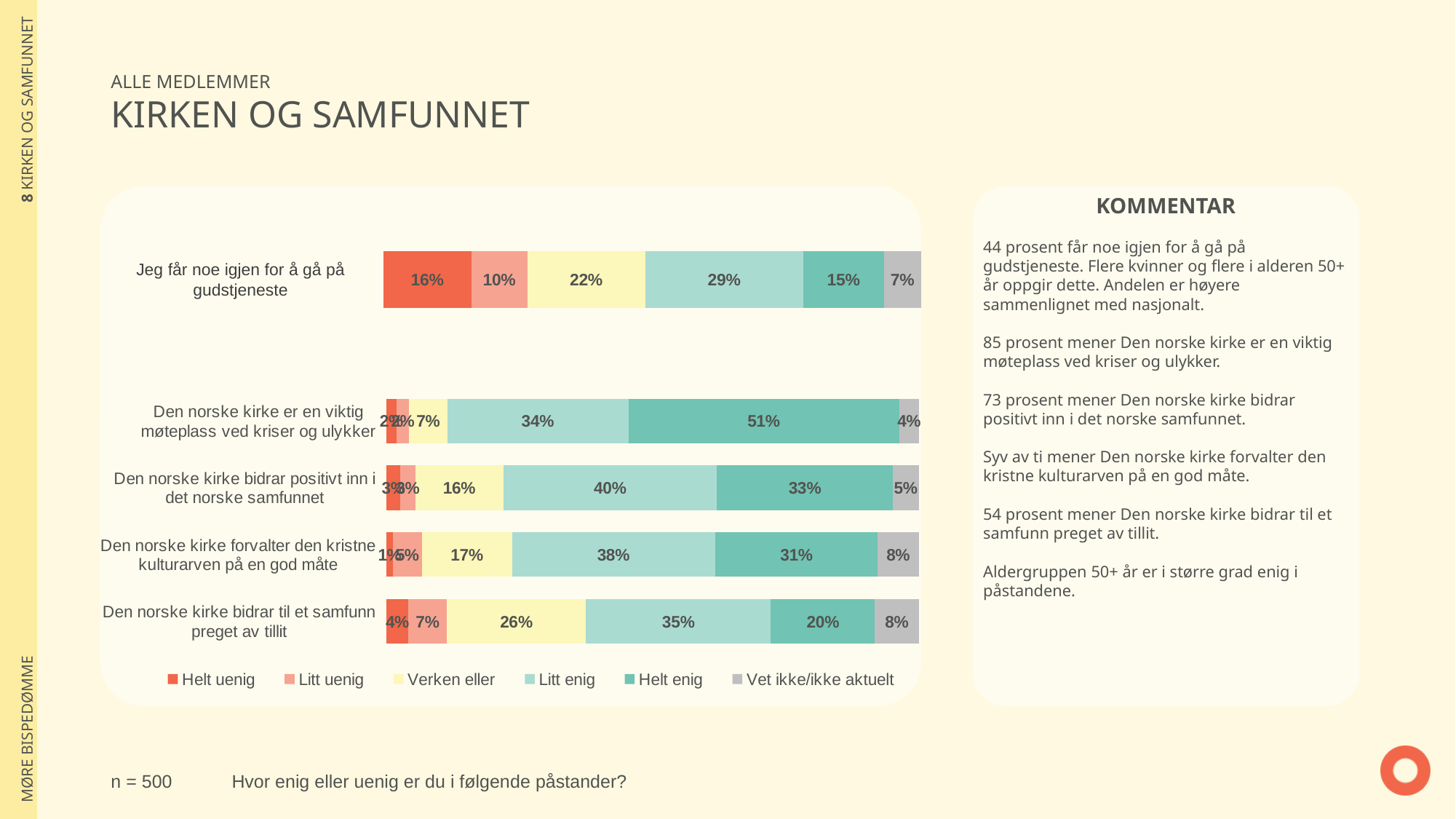
How many series does the legend list? 6 Which is larger: the 'Litt enig' value for 'Den norske kirke bidrar positivt inn i det norske samfunnet' or for 'Den norske kirke forvalter den kristne kulturarven på en god måte'? Den norske kirke bidrar positivt inn i det norske samfunnet What kind of chart is shown on the slide? Stacked bar chart What is the difference between the 'Helt enig' values for 'Den norske kirke er en viktig møteplass ved kriser og ulykker' and 'Den norske kirke bidrar til et samfunn preget av tillit'? 31 percentage points What is the 'Helt enig' value for 'Den norske kirke er en viktig møteplass ved kriser og ulykker'? 51% Which statement has the highest 'Helt uenig' value? Jeg får noe igjen for å gå på gudstjeneste Which statement has the lowest 'Helt enig' value? Jeg får noe igjen for å gå på gudstjeneste What is the sample size (n) stated on the slide? n = 500 What is the 'Verken eller' value for 'Den norske kirke bidrar til et samfunn preget av tillit'? 26% What is the 'Litt enig' value for 'Jeg får noe igjen for å gå på gudstjeneste'? 29% What is the 'Vet ikke/ikke aktuelt' value for 'Den norske kirke bidrar positivt inn i det norske samfunnet'? 5% How many statements (categories) are plotted in the chart? 5